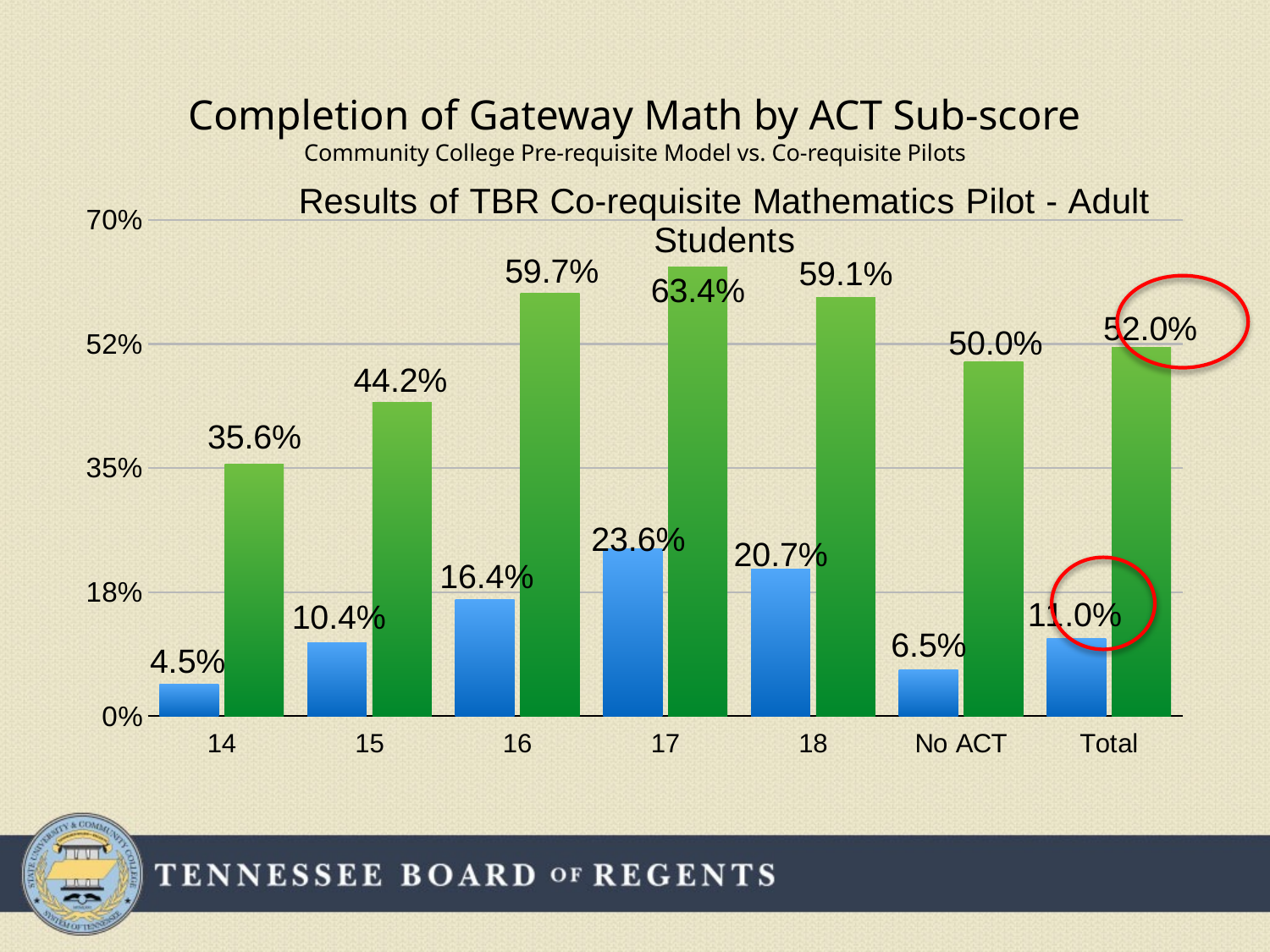
What is the value of the green bar for ACT sub-score 16? 59.7% What is the value of the green bar for the Total category? 52.0% What is the difference between the green bar and the blue bar for ACT sub-score 17? 39.8% Is the green bar for ACT sub-score 15 greater or less than 35%? greater Which category has the lowest blue bar? 14 Which is larger, the blue bar for ACT sub-score 18 or the blue bar for ACT sub-score 17? 17 How many categories are shown on the x axis? 7 Which category has the highest green bar? 17 What kind of chart is shown on the slide? Bar chart What is the value of the blue bar for the No ACT category? 6.5% What is the value of the blue bar for ACT sub-score 14? 4.5% What is the title of the chart? Results of TBR Co-requisite Mathematics Pilot - Adult Students